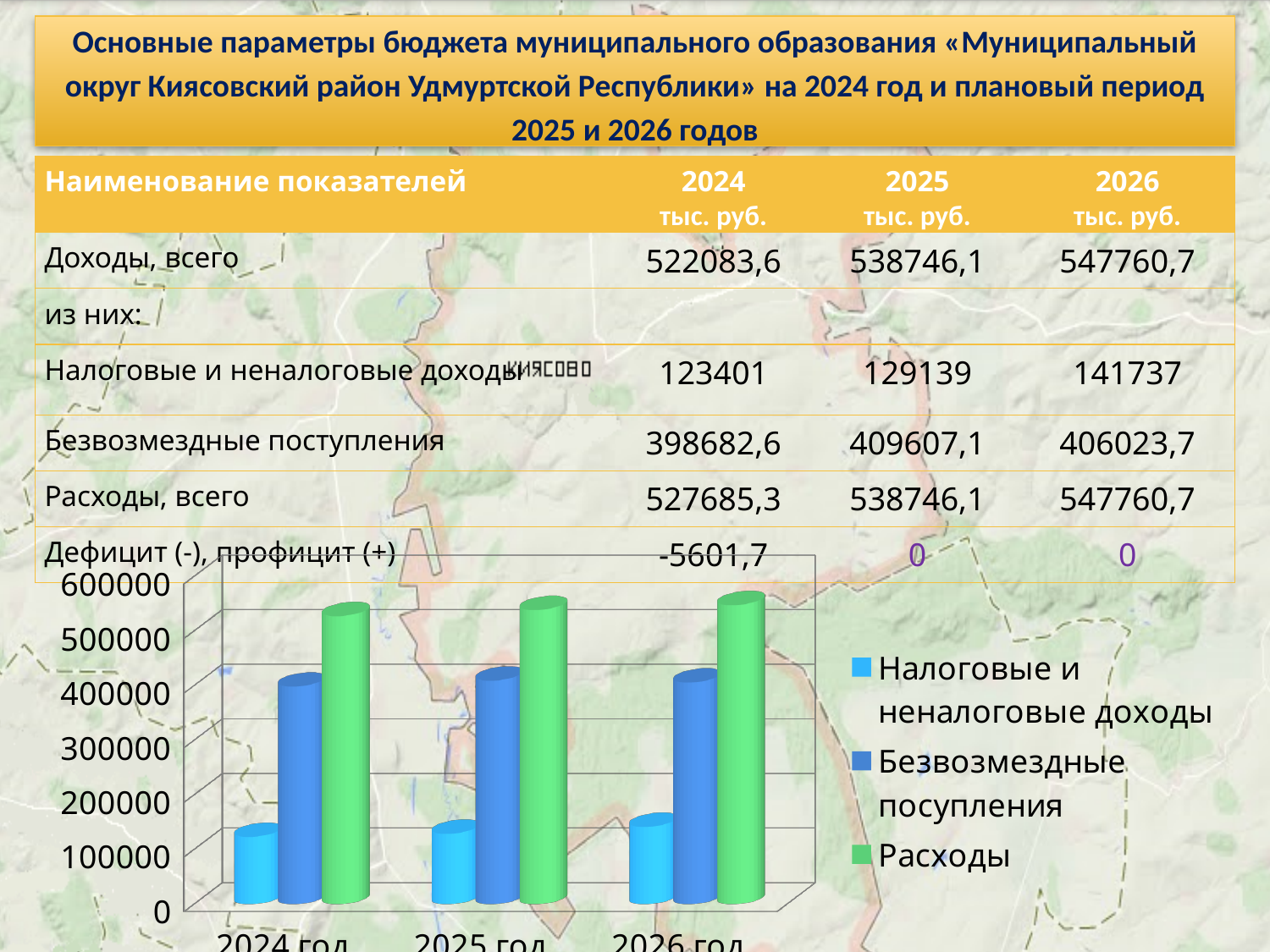
What colour are the bars for Расходы in the chart? green Is the value for Налоговые и неналоговые доходы in 2026 год greater or less than 200000? less Is the value for Расходы in 2024 год greater or less than 500000? greater Do the bars for Налоговые и неналоговые доходы rise or fall from 2024 год to 2026 год? rise Which series has the shortest bar in the 2026 год group? Налоговые и неналоговые доходы Is the value for Безвозмездные посупления in 2025 год greater or less than 300000? greater In 2025 год, which is larger: Безвозмездные посупления or Налоговые и неналоговые доходы? Безвозмездные посупления Which series has the tallest bar in the 2024 год group? Расходы How many series does the chart legend list? 3 What kind of chart is shown at the bottom of the slide? bar chart How many year categories are shown on the x axis of the chart? 3